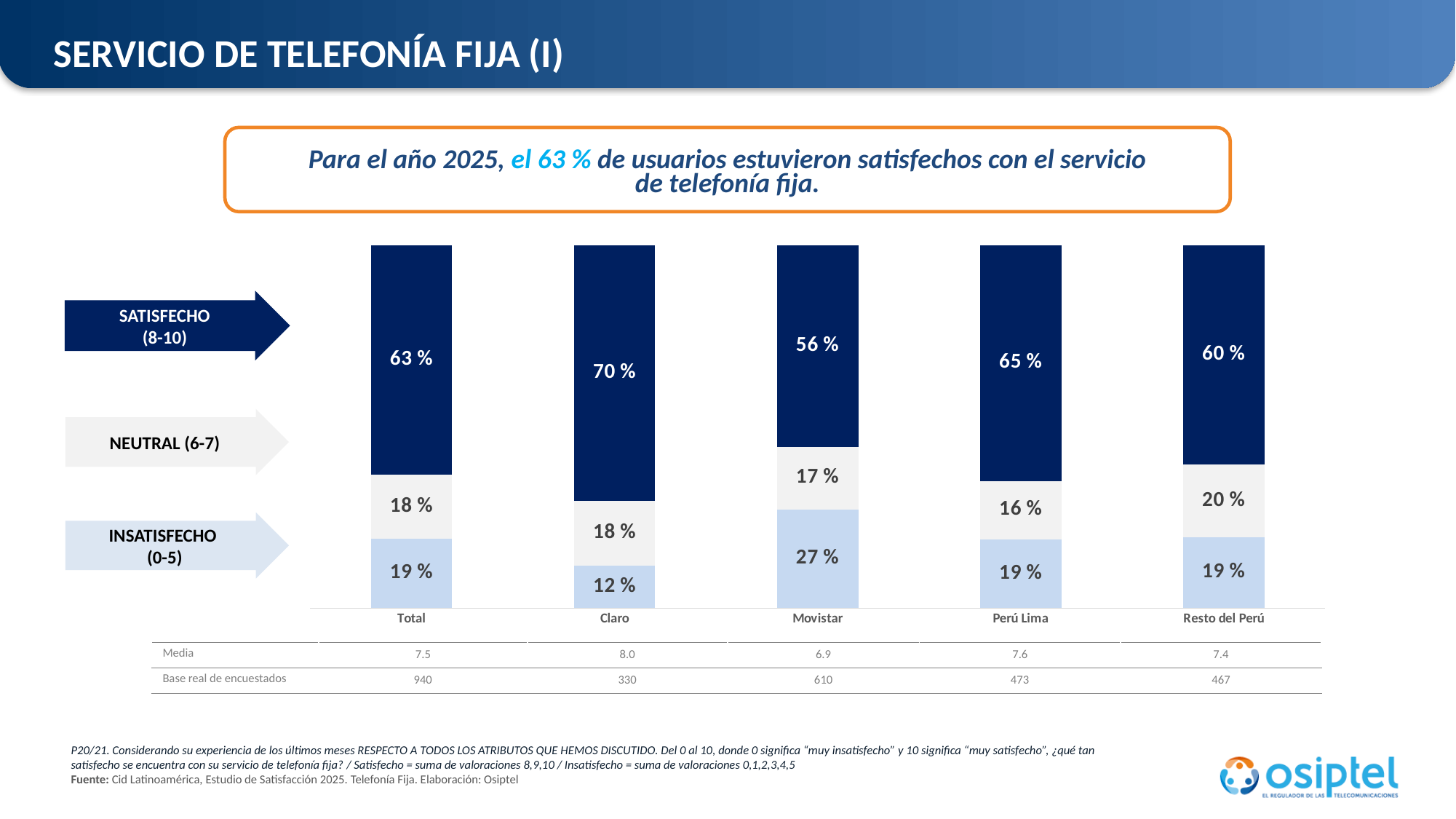
What is the Media value shown for Claro in the table below the chart? 8.0 What is the Neutral (6-7) percentage for Resto del Perú? 20 % How many series (satisfaction levels) are stacked in each bar? 3 What kind of chart is shown on the slide? Stacked bar chart What is the difference between the Satisfecho percentages of Claro and Movistar? 14 % How many categories are shown on the x axis of the chart? 5 What percentage of Claro users are Satisfecho (8-10)? 70 % Which has a higher Insatisfecho (0-5) percentage, Movistar or Claro? Movistar Which category has the highest Satisfecho (8-10) percentage? Claro What is the total of the stacked bar for Perú Lima? 100 % What is the Insatisfecho (0-5) percentage for Movistar? 27 % Which category has the lowest Satisfecho (8-10) percentage? Movistar